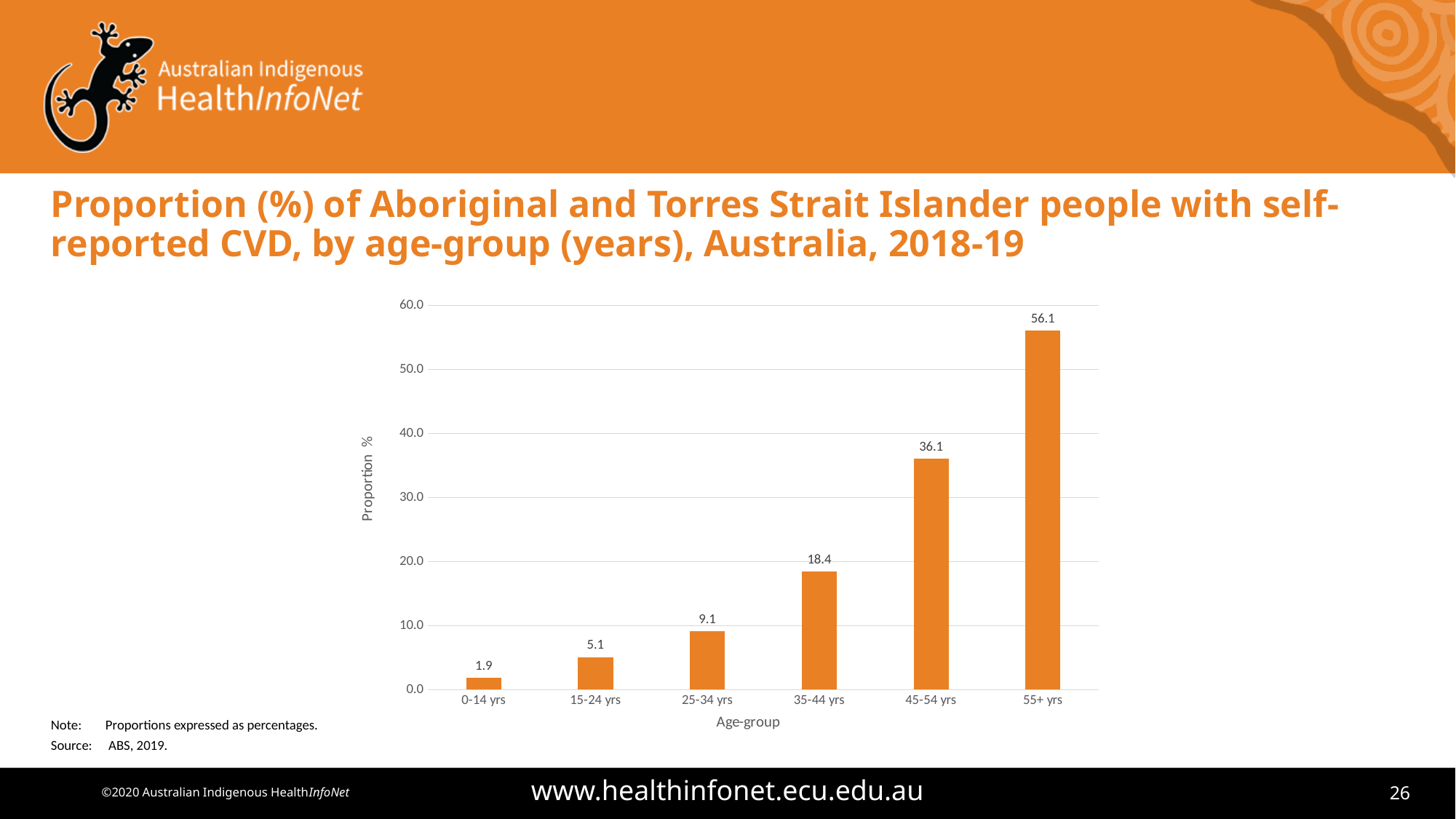
Do the proportions rise or fall as age-group increases along the x axis? Rise What is the difference in proportion between the 55+ yrs and 45-54 yrs age-groups? 20.0 What is the proportion of people with self-reported CVD in the 55+ yrs age-group? 56.1 Is the value for the 45-54 yrs age-group greater or less than 30.0? greater Which age-group has the highest proportion of self-reported CVD? 55+ yrs Which age-group has a larger proportion of self-reported CVD, 35-44 yrs or 45-54 yrs? 45-54 yrs Which age-group has the lowest proportion of self-reported CVD? 0-14 yrs How many age-groups are shown on the chart? 6 What is the difference in proportion between the 25-34 yrs and 15-24 yrs age-groups? 4.0 What kind of chart is shown on the slide? Bar chart What is the proportion of people with self-reported CVD in the 35-44 yrs age-group? 18.4 What is the proportion of people with self-reported CVD in the 0-14 yrs age-group? 1.9